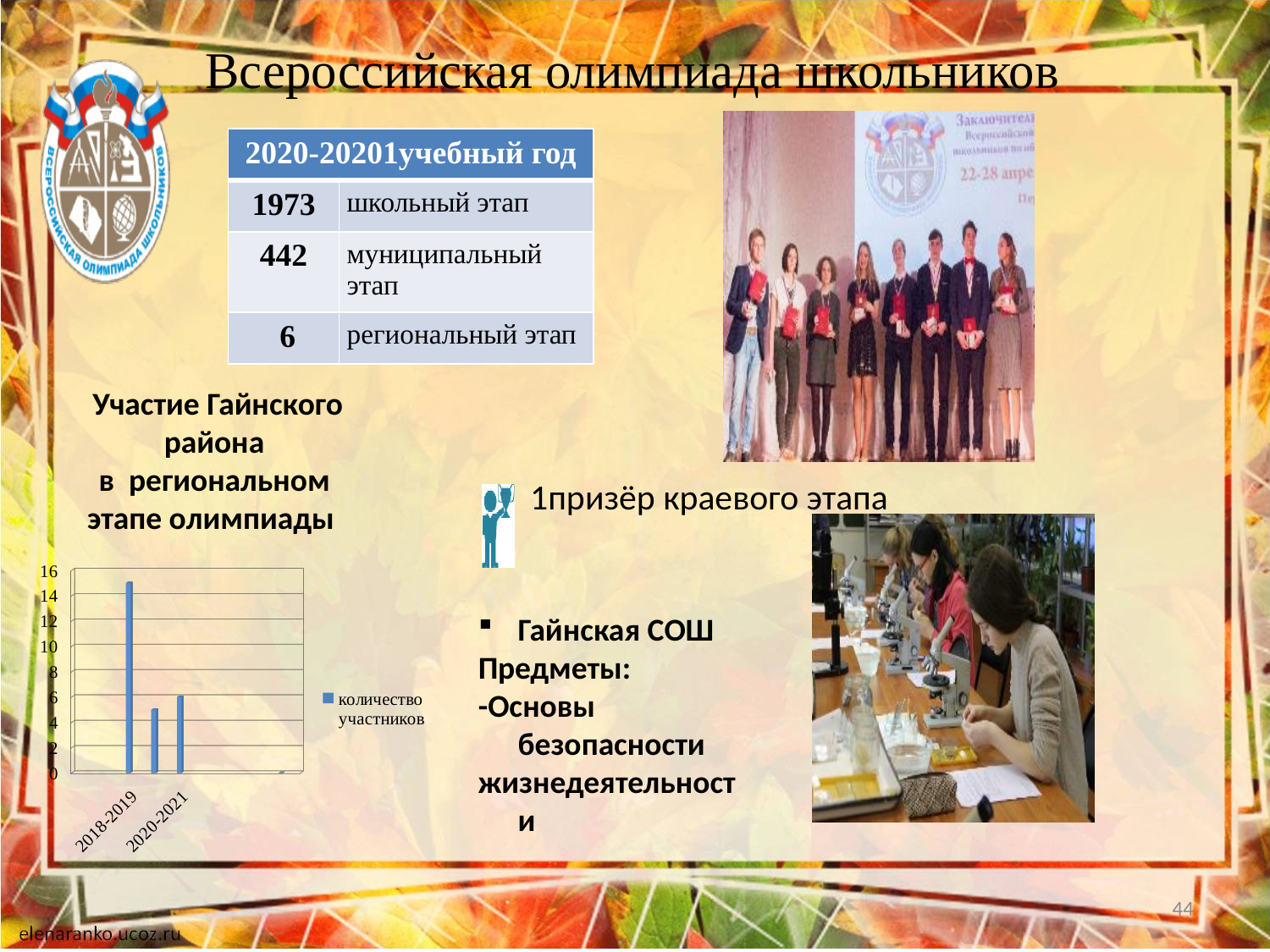
Which is larger, the value for 2018-2019 or the value for 2020-2021? 2018-2019 What is the series name shown in the chart legend? количество участников What is the highest value shown on the chart's vertical axis? 16 How many series does the chart legend list? 1 What kind of chart is shown on the slide? bar chart Which category has the highest value in the chart? 2018-2019 Is the value for 2018-2019 greater or less than 10? greater Is the value for 2020-2021 greater or less than 10? less